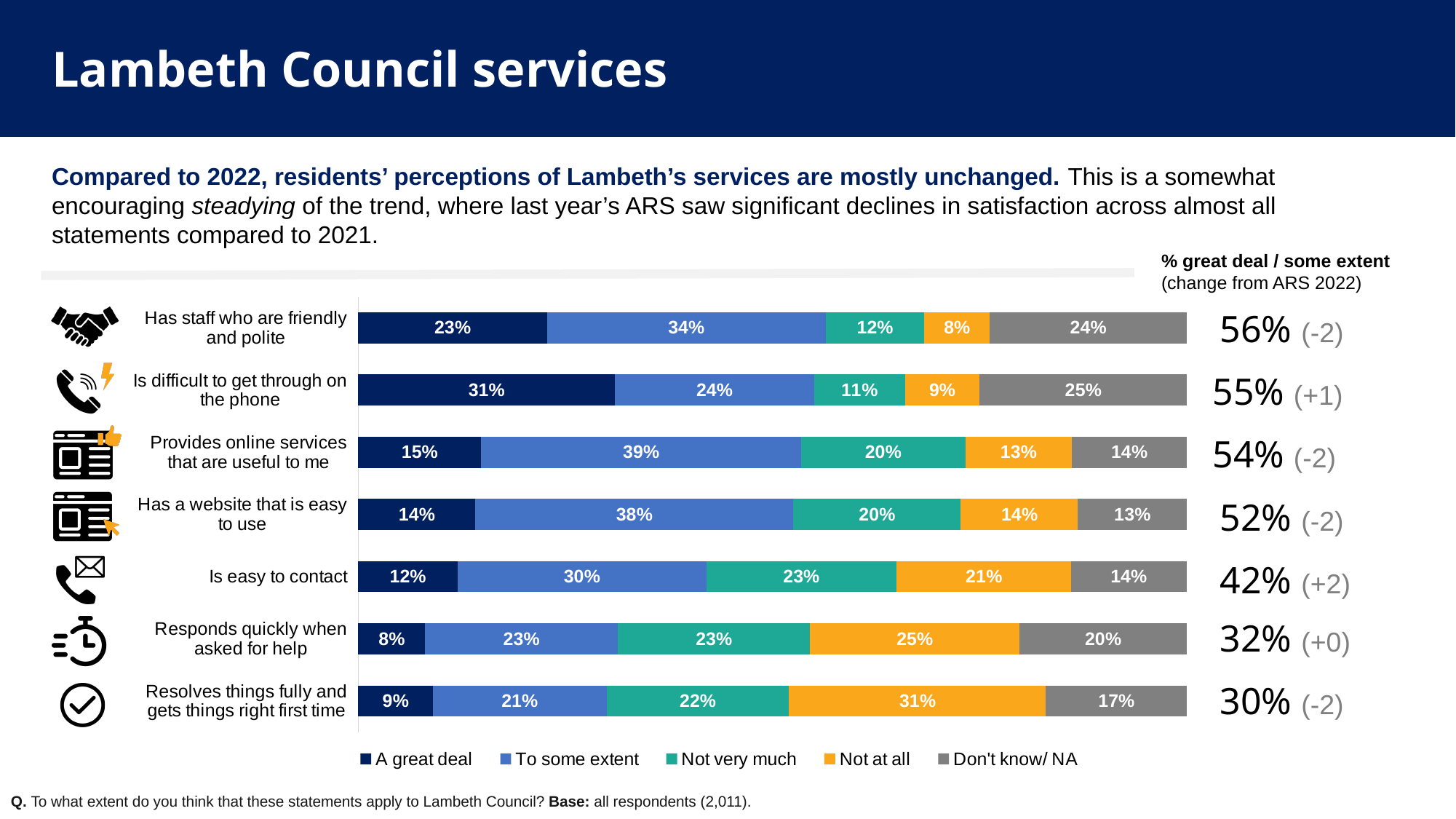
What percentage of respondents said 'A great deal' for 'Is difficult to get through on the phone'? 31% What percentage of respondents said 'Don't know/ NA' for 'Has staff who are friendly and polite'? 24% How many statements are shown in the chart? 7 How many series does the legend list? 5 What percentage of respondents said 'To some extent' for 'Provides online services that are useful to me'? 39% What is the difference between the 'Not at all' percentages for 'Resolves things fully and gets things right first time' and 'Has staff who are friendly and polite'? 23 percentage points Which statement has the lowest 'A great deal' percentage? Responds quickly when asked for help Which is larger: the 'Not very much' percentage for 'Is easy to contact' or for 'Has a website that is easy to use'? Is easy to contact What kind of chart is shown on the slide? Stacked bar chart What is the combined '% great deal / some extent' figure shown for 'Is easy to contact'? 42% What percentage of respondents said 'Not at all' for 'Resolves things fully and gets things right first time'? 31% Which statement has the highest 'A great deal' percentage? Is difficult to get through on the phone